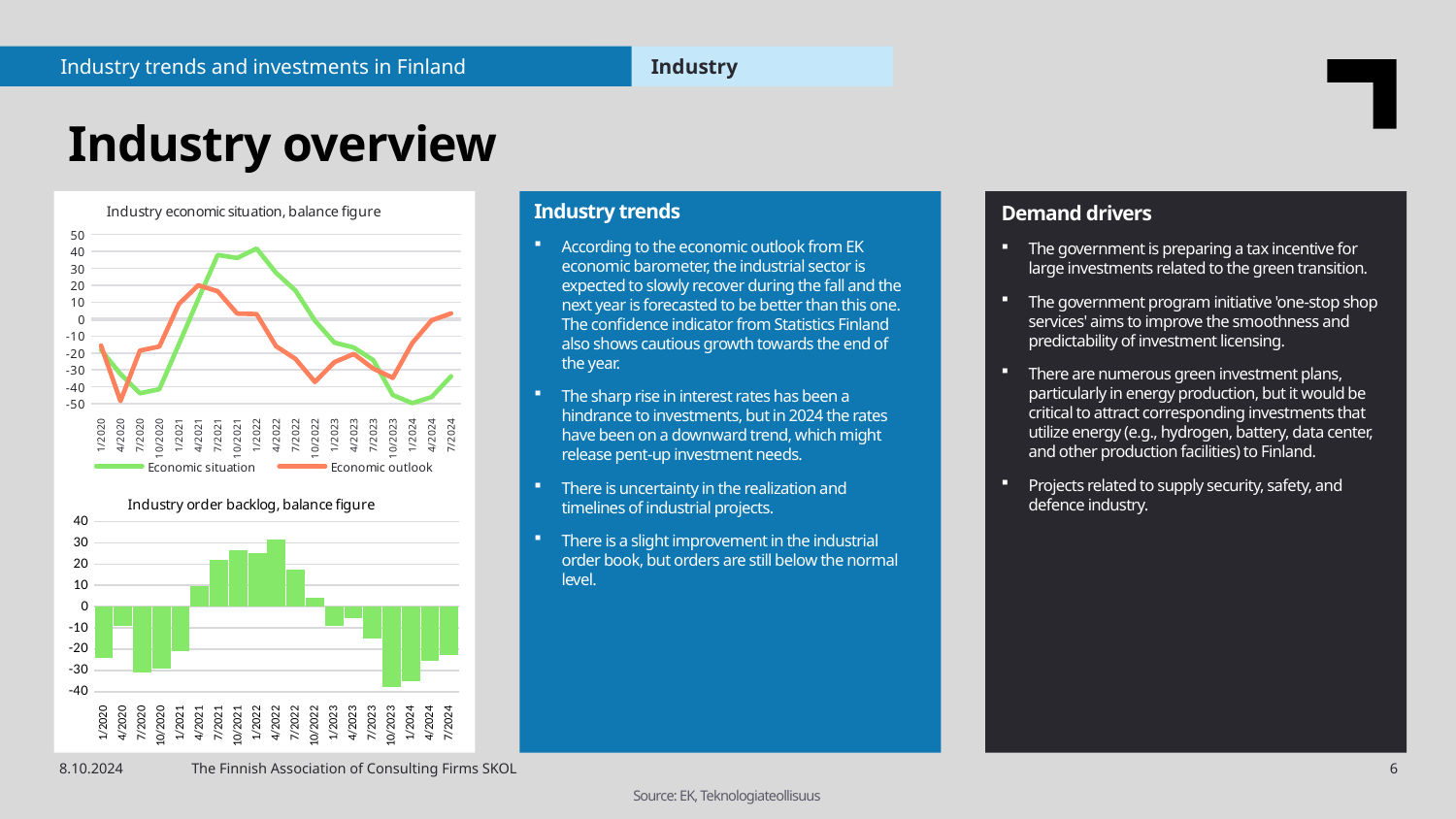
What kind of chart is the 'Industry economic situation, balance figure' chart? line chart In the 'Industry economic situation, balance figure' chart, is the Economic outlook value at 4/2020 greater or less than -40? less In the 'Industry order backlog, balance figure' chart, is the value for 4/2022 greater or less than 20? greater What are the two legend entries in the 'Industry economic situation, balance figure' chart? Economic situation and Economic outlook How many bars are plotted in the 'Industry order backlog, balance figure' chart? 19 In the 'Industry order backlog, balance figure' chart, which period has the lowest bar? 10/2023 In the 'Industry economic situation, balance figure' chart, which series has the higher value at 1/2021? Economic outlook In the 'Industry economic situation, balance figure' chart, is the Economic situation value at 1/2022 greater or less than 30? greater In the 'Industry order backlog, balance figure' chart, which period has the highest bar? 4/2022 In the 'Industry order backlog, balance figure' chart, do the values rise or fall from 4/2022 to 1/2024? fall What kind of chart is the 'Industry order backlog, balance figure' chart? bar chart How many series does the legend of the 'Industry economic situation, balance figure' chart list? 2